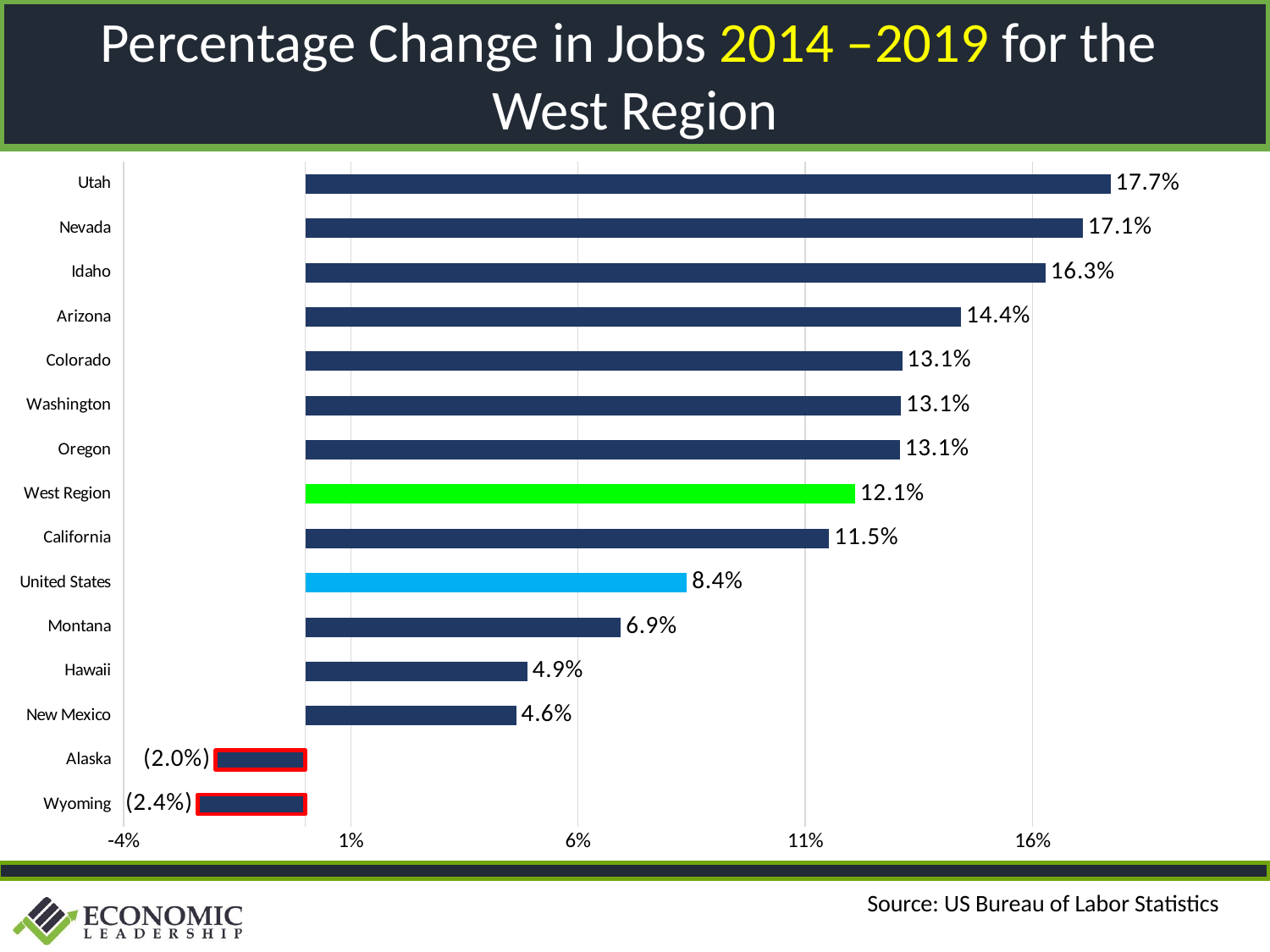
What is the value shown for Wyoming? (2.4%) What is the value shown for the United States? 8.4% What is the value shown for the West Region? 12.1% What is the difference between the values for the West Region and the United States? 3.7% Which has a larger percentage change in jobs, Arizona or California? Arizona Which category has the highest percentage change in jobs? Utah What is the percentage change in jobs for Utah? 17.7% What is the difference between the values for Utah and Nevada? 0.6% Which category has the lowest percentage change in jobs? Wyoming What kind of chart is shown on the slide? Bar chart What colour is the bar for the West Region? Green How many categories are shown in the chart? 15